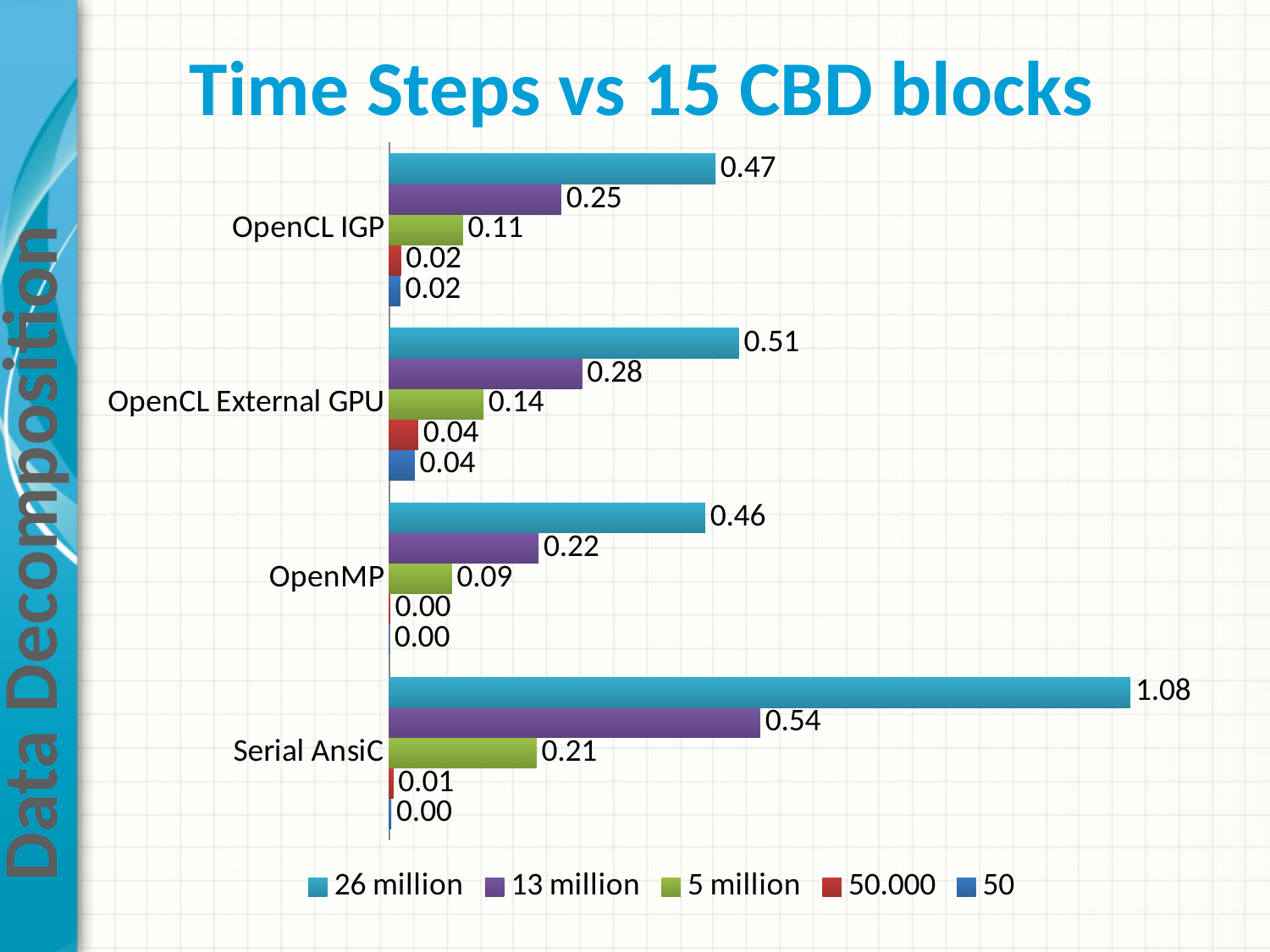
What is the value for OpenMP in the 5 million series? 0.09 What is the difference between the 26 million values for Serial AnsiC and OpenCL External GPU? 0.57 How many series does the legend list? 5 What kind of chart is shown on the slide? Bar chart What is the value for OpenCL External GPU in the 13 million series? 0.28 Which category has the highest value in the 26 million series? Serial AnsiC What is the value for Serial AnsiC in the 26 million series? 1.08 Which category has the lowest value in the 13 million series? OpenMP How many categories are shown on the chart? 4 What is the title of the chart? Time Steps vs 15 CBD blocks What is the value for OpenCL IGP in the 50.000 series? 0.02 Which is larger in the 5 million series: OpenCL IGP or OpenCL External GPU? OpenCL External GPU